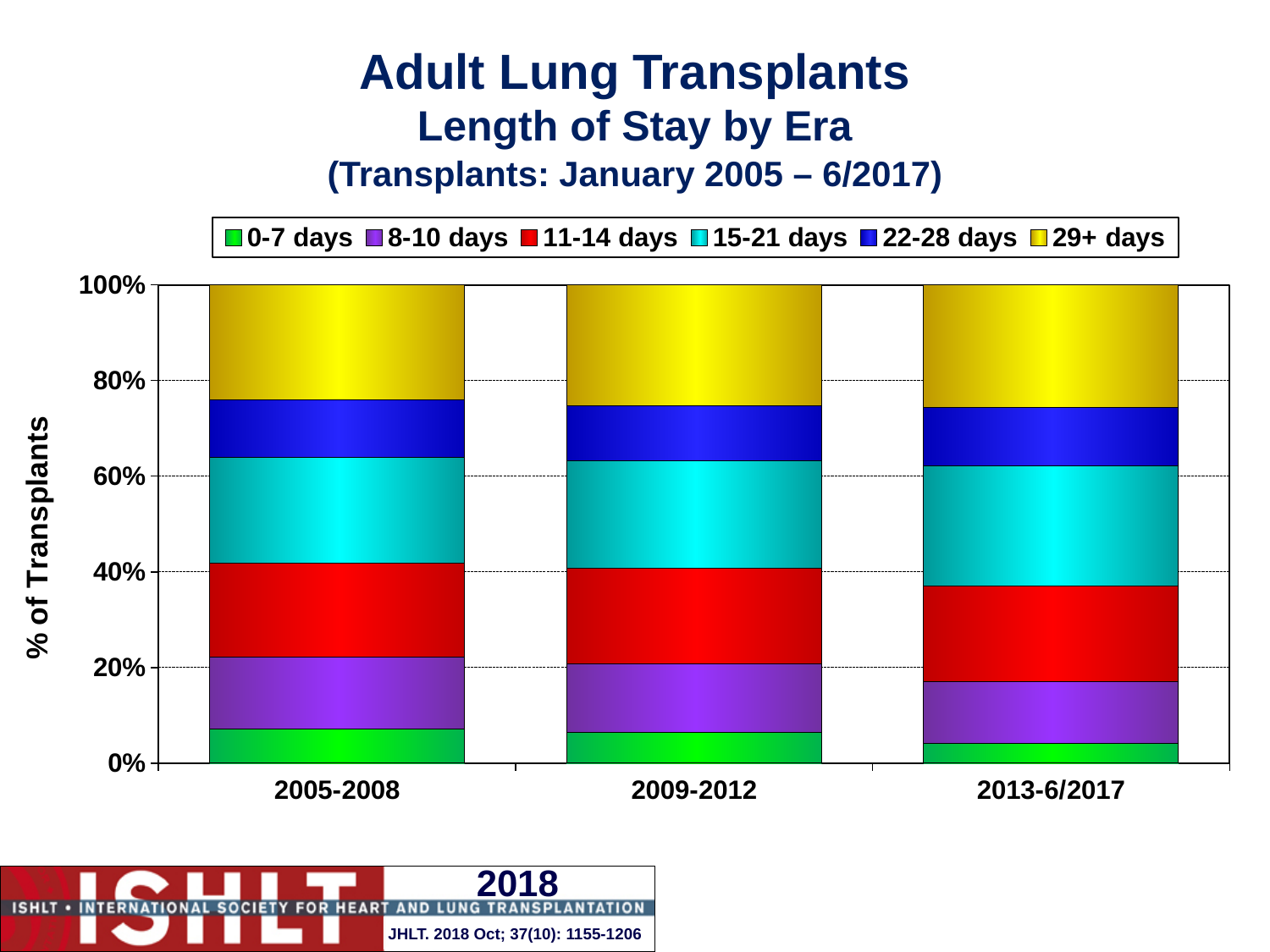
What is the total height of the stacked bar for 2009-2012? 100% Which length-of-stay segment is the smallest in the 2013-6/2017 bar? 0-7 days How many length-of-stay series does the legend list? 6 How many era categories are shown on the x axis? 3 In the 2005-2008 bar, is the cumulative percentage at the top of the 22-28 days segment greater or less than 80%? less In the 2013-6/2017 bar, is the cumulative percentage at the top of the 11-14 days segment greater or less than 40%? less Does the share of transplants with a 0-7 day stay rise or fall across the eras from 2005-2008 to 2013-6/2017? Fall Is the 0-7 days segment larger in the 2005-2008 bar or in the 2013-6/2017 bar? 2005-2008 Which length-of-stay category is shown in yellow in the legend? 29+ days Which length-of-stay segment is the smallest in the 2005-2008 bar? 0-7 days What kind of chart is shown on the slide? Stacked bar chart What is the label of the y axis? % of Transplants